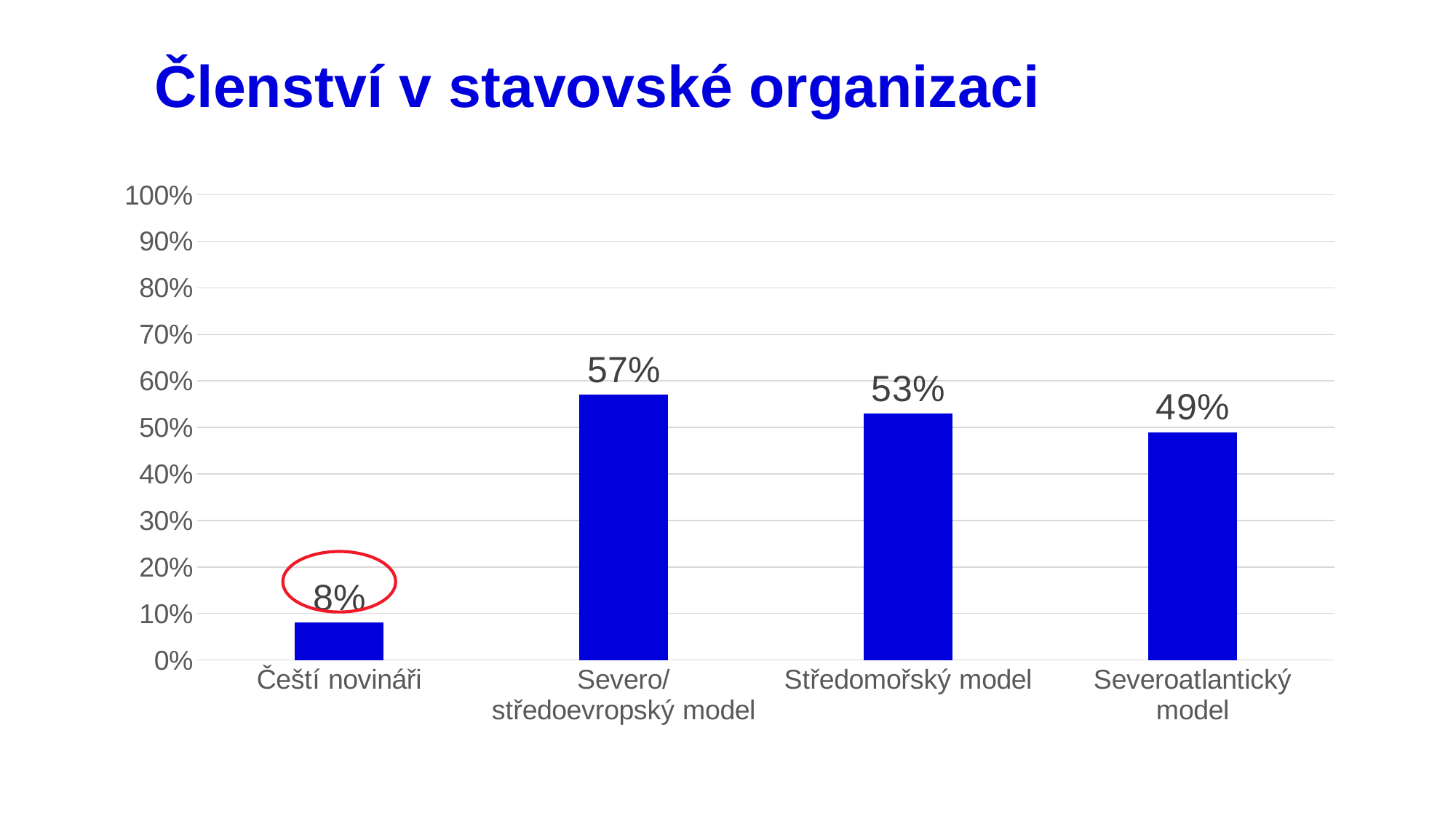
What is the value for Čeští novináři? 8% What is the value for Severoatlantický model? 49% Which is larger, the value for Středomořský model or the value for Severoatlantický model? Středomořský model What is the value for Středomořský model? 53% What kind of chart is shown on the slide? Bar chart Which category has the lowest value? Čeští novináři What is the difference between the values for Středomořský model and Severoatlantický model? 4% What is the difference between the values for Severo/středoevropský model and Čeští novináři? 49% Which category has the highest value? Severo/středoevropský model What is the title of the slide? Členství v stavovské organizaci What is the value for Severo/středoevropský model? 57% How many categories are shown in the chart? 4